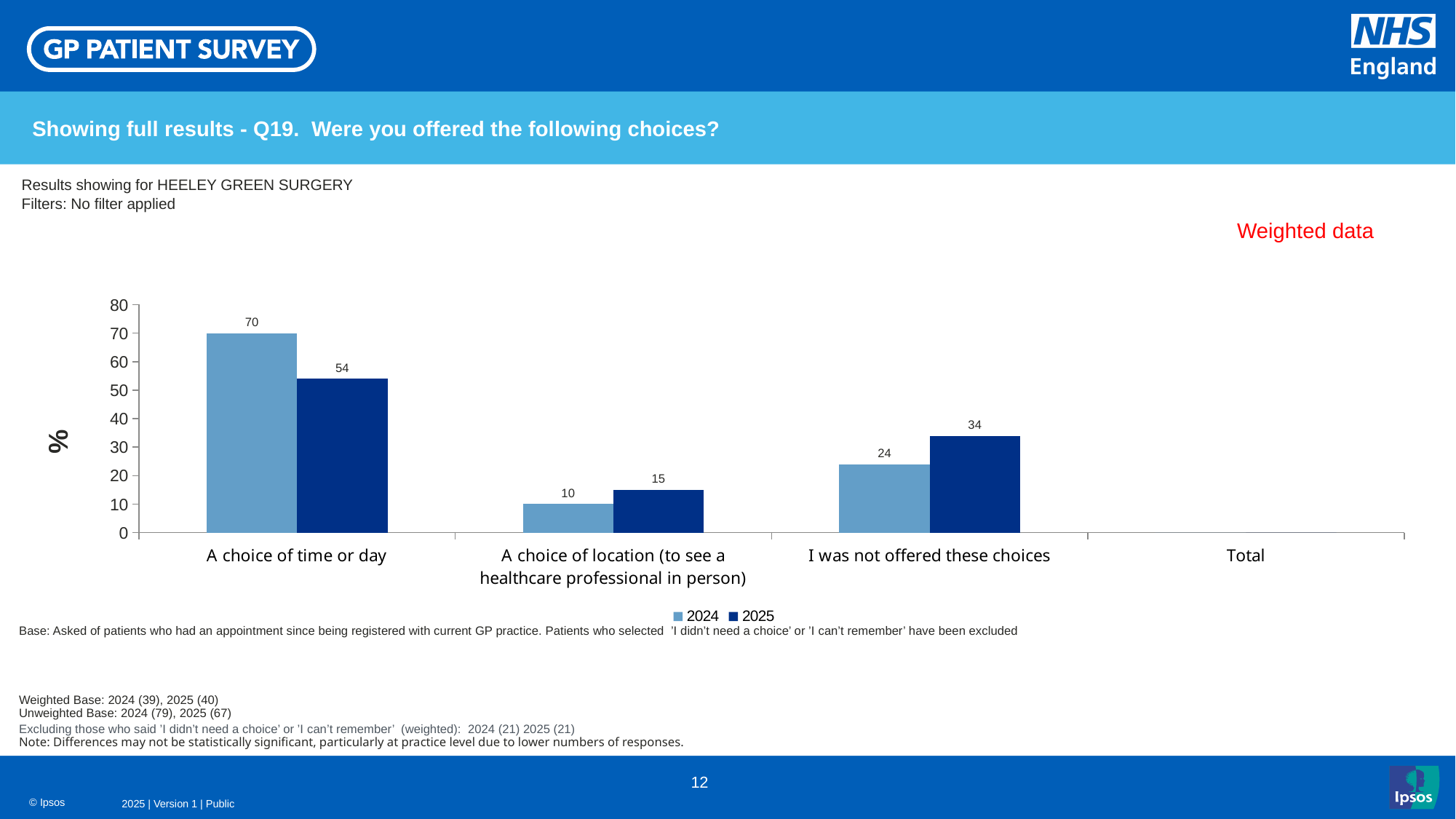
Is the 2024 value for 'I was not offered these choices' greater or less than 30? less What is the 2025 value for 'A choice of location (to see a healthcare professional in person)'? 15 What is the 2025 value for 'I was not offered these choices'? 34 What is the difference between the 2024 and 2025 values for 'A choice of time or day'? 16 What is the difference between the 2025 and 2024 values for 'I was not offered these choices'? 10 What is the 2024 value for 'A choice of time or day'? 70 What kind of chart is shown on the slide? Bar chart Which is larger for 'A choice of location (to see a healthcare professional in person)': the 2024 value or the 2025 value? 2025 How many series does the legend list? 2 Which category has the lowest 2024 value? A choice of location (to see a healthcare professional in person) Which category has the highest 2025 value? A choice of time or day What unit is shown on the vertical axis label? %